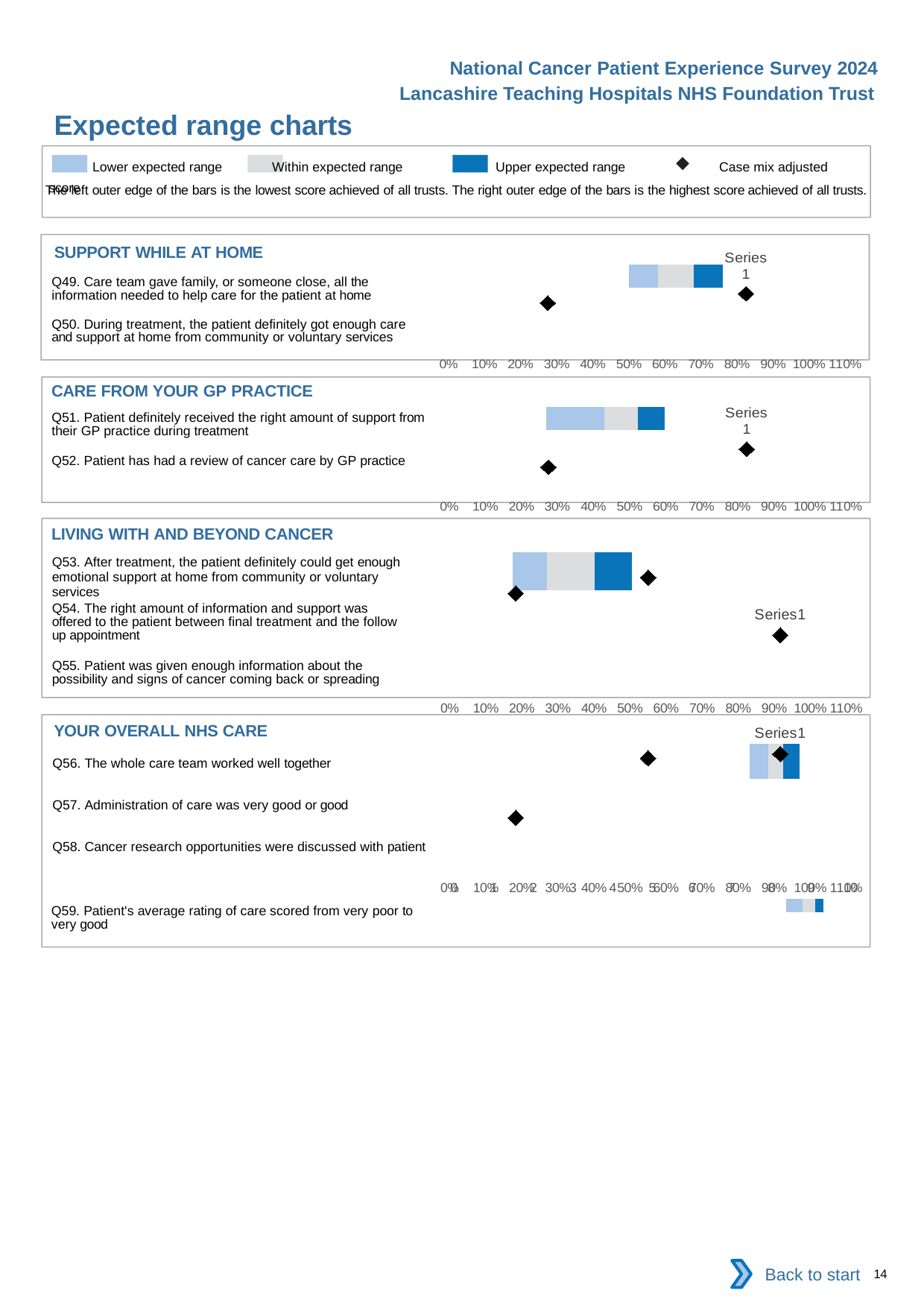
How many questions are listed in the LIVING WITH AND BEYOND CANCER section? 3 In the LIVING WITH AND BEYOND CANCER chart, is the rightmost case mix adjusted score diamond greater or less than 80%? greater According to the legend, what does the diamond marker represent? Case mix adjusted score How many questions are listed in the YOUR OVERALL NHS CARE section? 4 How many entries does the legend at the top of the slide list? 4 In the SUPPORT WHILE AT HOME chart, is the rightmost case mix adjusted score diamond greater or less than 70%? greater In the CARE FROM YOUR GP PRACTICE chart, is the leftmost case mix adjusted score diamond greater or less than 40%? less How many questions are listed in the SUPPORT WHILE AT HOME section? 2 What is the highest tick label shown on the x axis of the CARE FROM YOUR GP PRACTICE chart? 110% What kind of chart is used in the SUPPORT WHILE AT HOME section? Bar chart